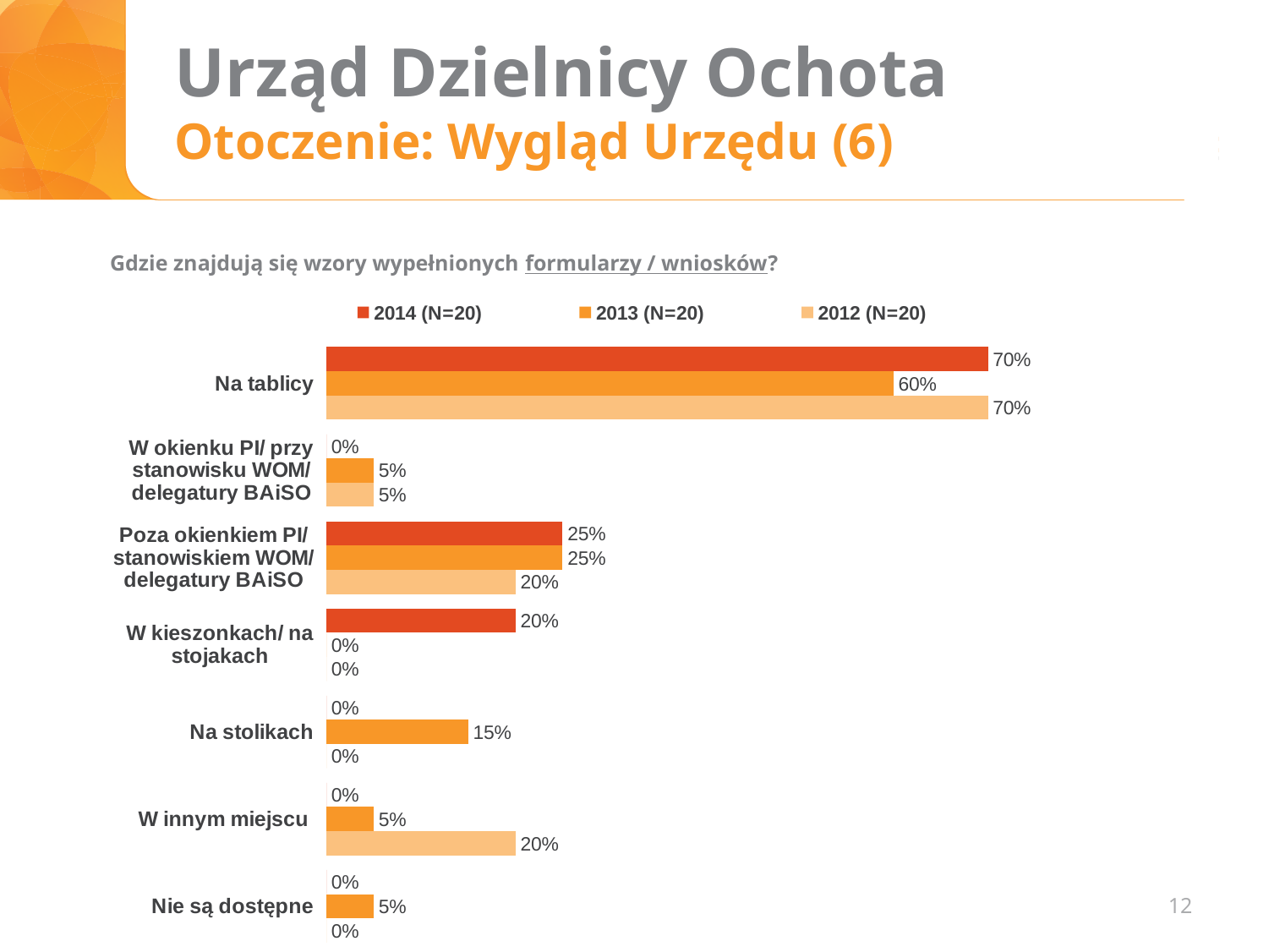
How many categories are shown on the chart? 7 What is the value for "Na stolikach" in the 2013 (N=20) series? 15% What question does the chart answer, as written above it? Gdzie znajdują się wzory wypełnionych formularzy / wniosków? What kind of chart is shown on the slide? Bar chart How many series does the legend list? 3 What is the value for "Na tablicy" in the 2013 (N=20) series? 60% What is the difference between the 2012 (N=20) and 2013 (N=20) values for "W innym miejscu"? 15% What is the difference between the 2014 (N=20) and 2013 (N=20) values for "Na tablicy"? 10% Which category has the highest value in the 2014 (N=20) series? Na tablicy Which is larger for "Poza okienkiem PI/ stanowiskiem WOM/ delegatury BAiSO": the 2014 (N=20) value or the 2012 (N=20) value? 2014 (N=20) What is the value for "W kieszonkach/ na stojakach" in the 2014 (N=20) series? 20% What is the value for "W innym miejscu" in the 2012 (N=20) series? 20%